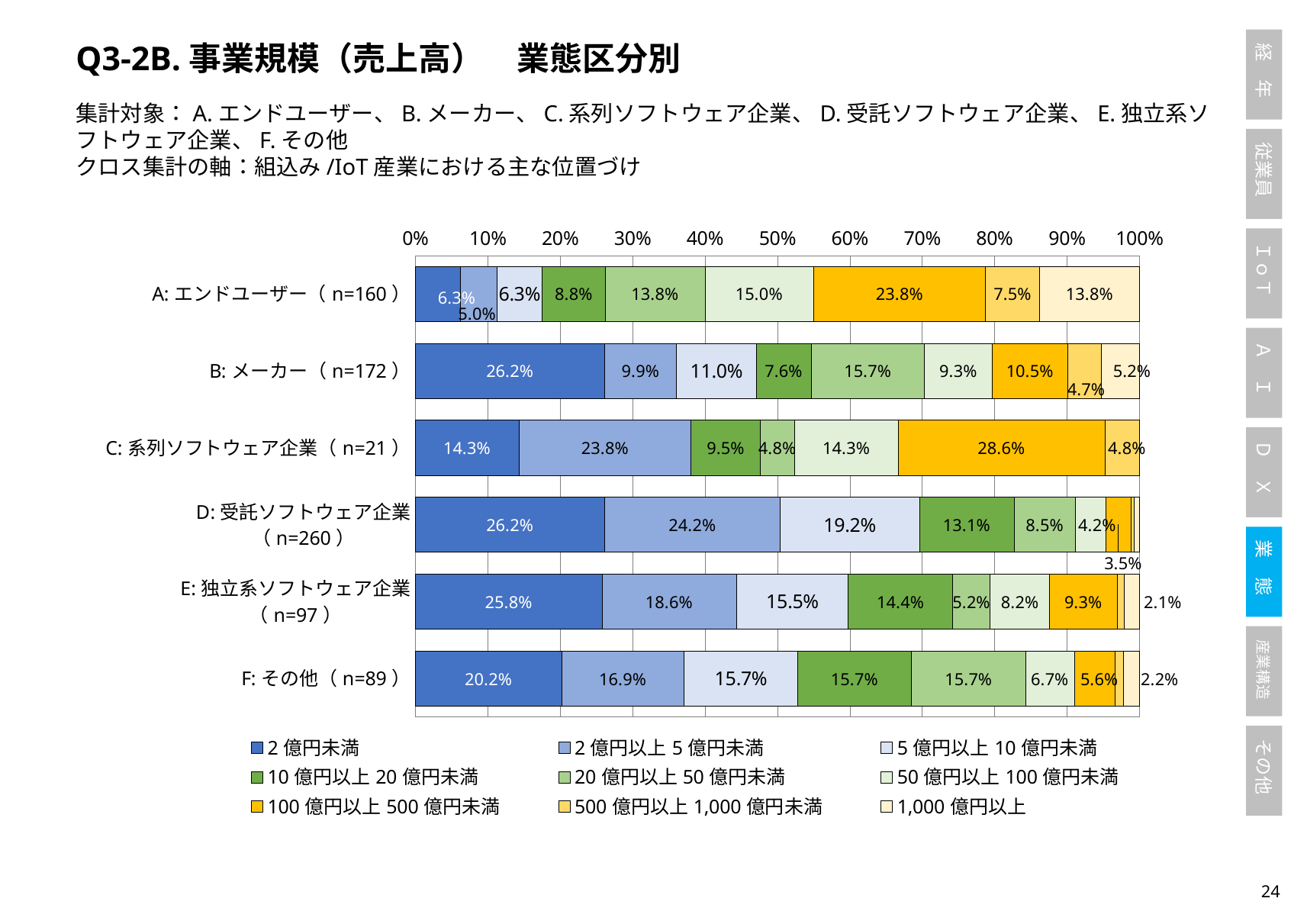
How many series does the legend list? 9 Which has the larger 2億円未満 share, E: 独立系ソフトウェア企業 or F: その他? E: 独立系ソフトウェア企業 Which category has the lowest share of 2億円未満? A: エンドユーザー What is the value of 2億円未満 for B: メーカー? 26.2% How many categories (業態区分) are plotted on the chart? 6 For D: 受託ソフトウェア企業, what is the difference between the 2億円未満 share and the 2億円以上5億円未満 share? 2.0% What is the value of 100億円以上500億円未満 for A: エンドユーザー? 23.8% Which category has the highest share of 100億円以上500億円未満? C: 系列ソフトウェア企業 What kind of chart is shown on the slide? bar chart What is the sample size (n) shown for D: 受託ソフトウェア企業? 260 What is the value of 100億円以上500億円未満 for C: 系列ソフトウェア企業? 28.6% What is the value of 5億円以上10億円未満 for D: 受託ソフトウェア企業? 19.2%